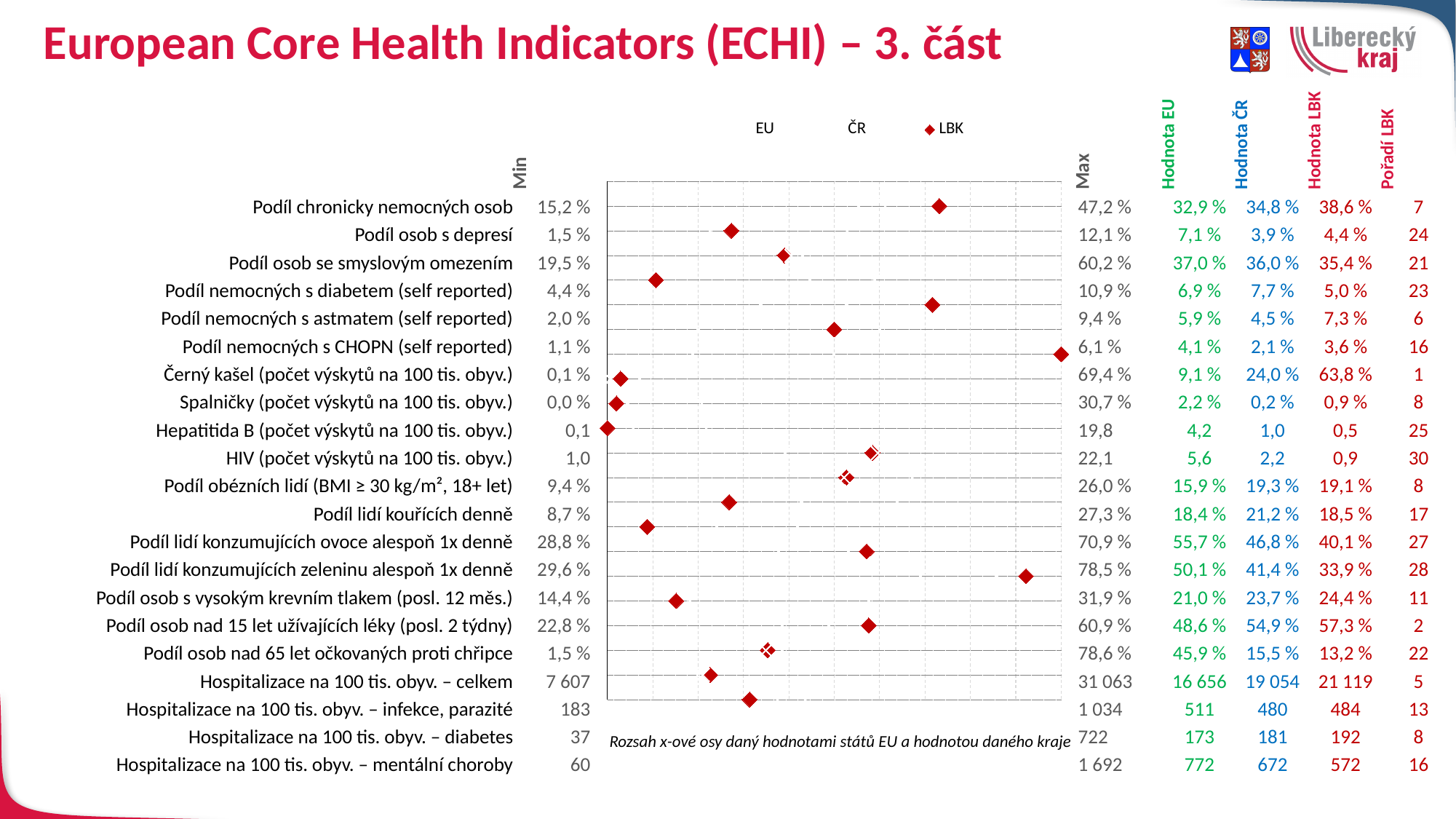
For Podíl osob nad 15 let užívajících léky (posl. 2 týdny), which is larger: Hodnota ČR or Hodnota LBK? Hodnota LBK What is the Hodnota EU value for Podíl lidí kouřících denně? 18,4 % What is the Hodnota ČR value for Hospitalizace na 100 tis. obyv. – infekce, parazité? 480 What is the difference between Hodnota LBK and Hodnota EU for Podíl chronicky nemocných osob? 5,7 % How many indicators (rows) are shown in the chart? 21 What colour is the LBK marker in the chart legend? Red What is the difference between Hodnota EU and Hodnota LBK for Hospitalizace na 100 tis. obyv. – mentální choroby? 200 How many series does the chart legend list? 3 What is the Min value for Podíl osob s depresí? 1,5 % What is the Max value for Hospitalizace na 100 tis. obyv. – celkem? 31 063 What is the Hodnota LBK value for Podíl chronicky nemocných osob? 38,6 % What is the Pořadí LBK for Černý kašel (počet výskytů na 100 tis. obyv.)? 1